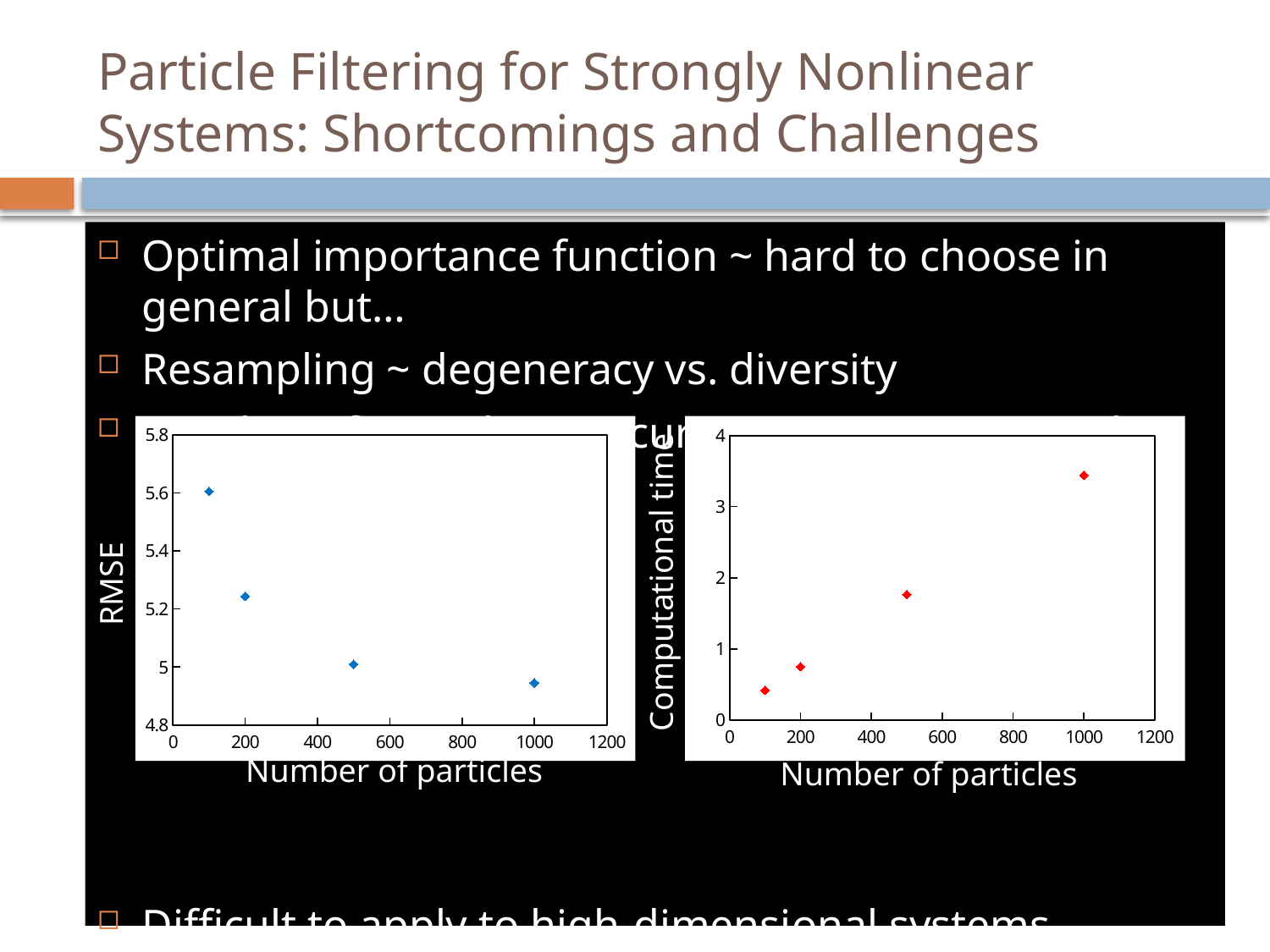
In the left chart (RMSE vs Number of particles), how many data points are plotted? 4 In the left chart (RMSE vs Number of particles), which has the larger RMSE: 100 particles or 1000 particles? 100 particles In the left chart (RMSE vs Number of particles), what kind of chart is shown? scatter chart In the left chart (RMSE vs Number of particles), is the RMSE at 500 particles greater or less than 5.2? less In the right chart (Computational time vs Number of particles), does computational time rise or fall as the number of particles increases? rise In the left chart (RMSE vs Number of particles), at which number of particles is RMSE highest? 100 In the left chart (RMSE vs Number of particles), is the RMSE at 100 particles greater or less than 5.4? greater In the right chart (Computational time vs Number of particles), how many data points are plotted? 4 In the right chart (Computational time vs Number of particles), at which number of particles is computational time lowest? 100 In the right chart (Computational time vs Number of particles), is the computational time at 1000 particles greater or less than 3? greater In the left chart (RMSE vs Number of particles), does RMSE rise or fall as the number of particles increases? fall In the right chart, what is the label on the y axis? Computational time